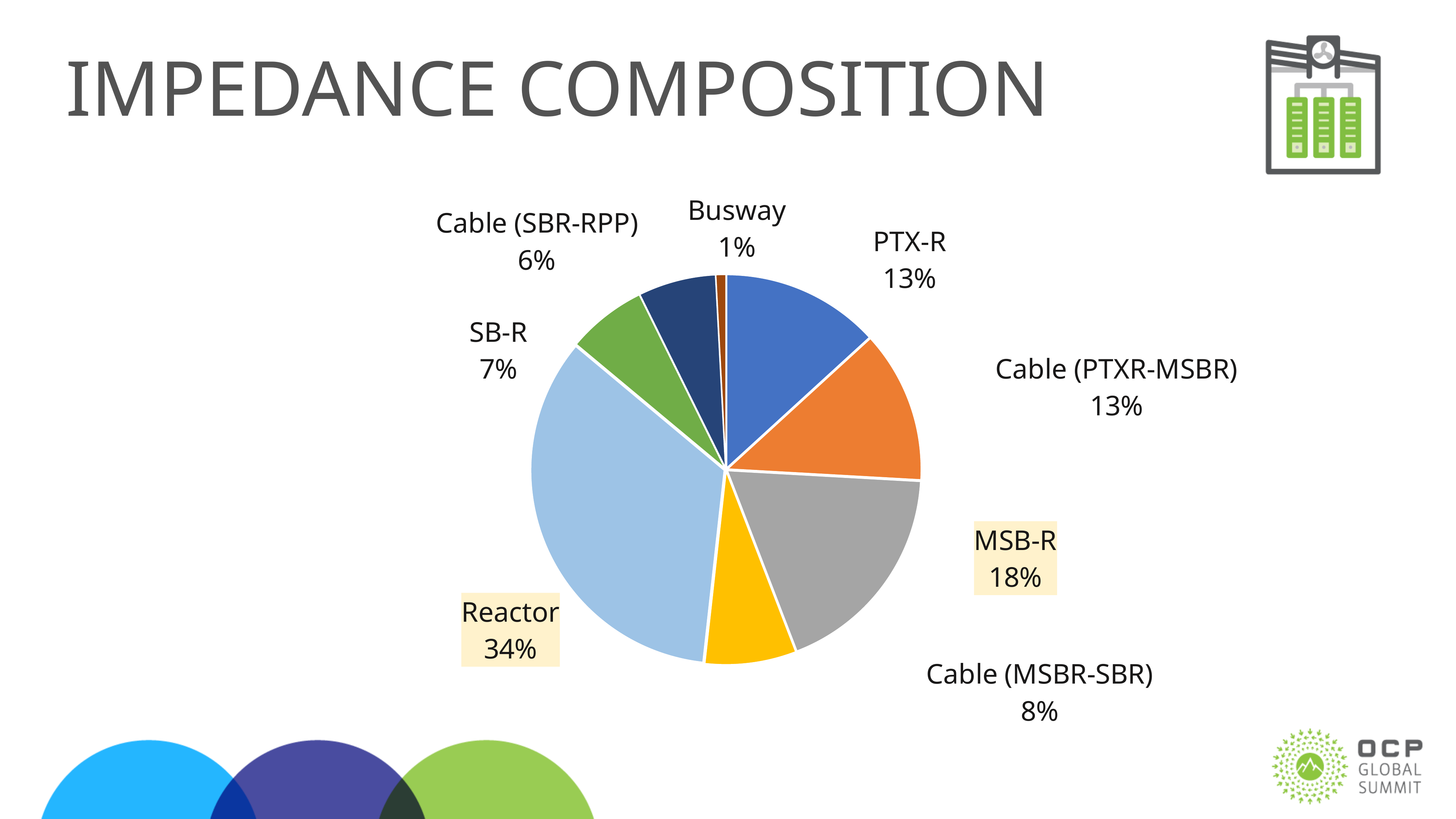
What is the combined share of PTX-R and Cable (PTXR-MSBR)? 26% Which category has the smallest slice of the pie? Busway What is the title of the slide containing the chart? IMPEDANCE COMPOSITION What is the value shown for Busway? 1% Which category has the largest slice of the pie? Reactor How many categories are shown in the pie chart? 8 Which is larger, the share for SB-R or the share for Cable (SBR-RPP)? SB-R What is the value shown for MSB-R? 18% What share of the pie does Reactor account for? 34% What is the difference between the Reactor share and the MSB-R share? 16% What is the value shown for Cable (MSBR-SBR)? 8% What kind of chart is shown on the slide? Pie chart